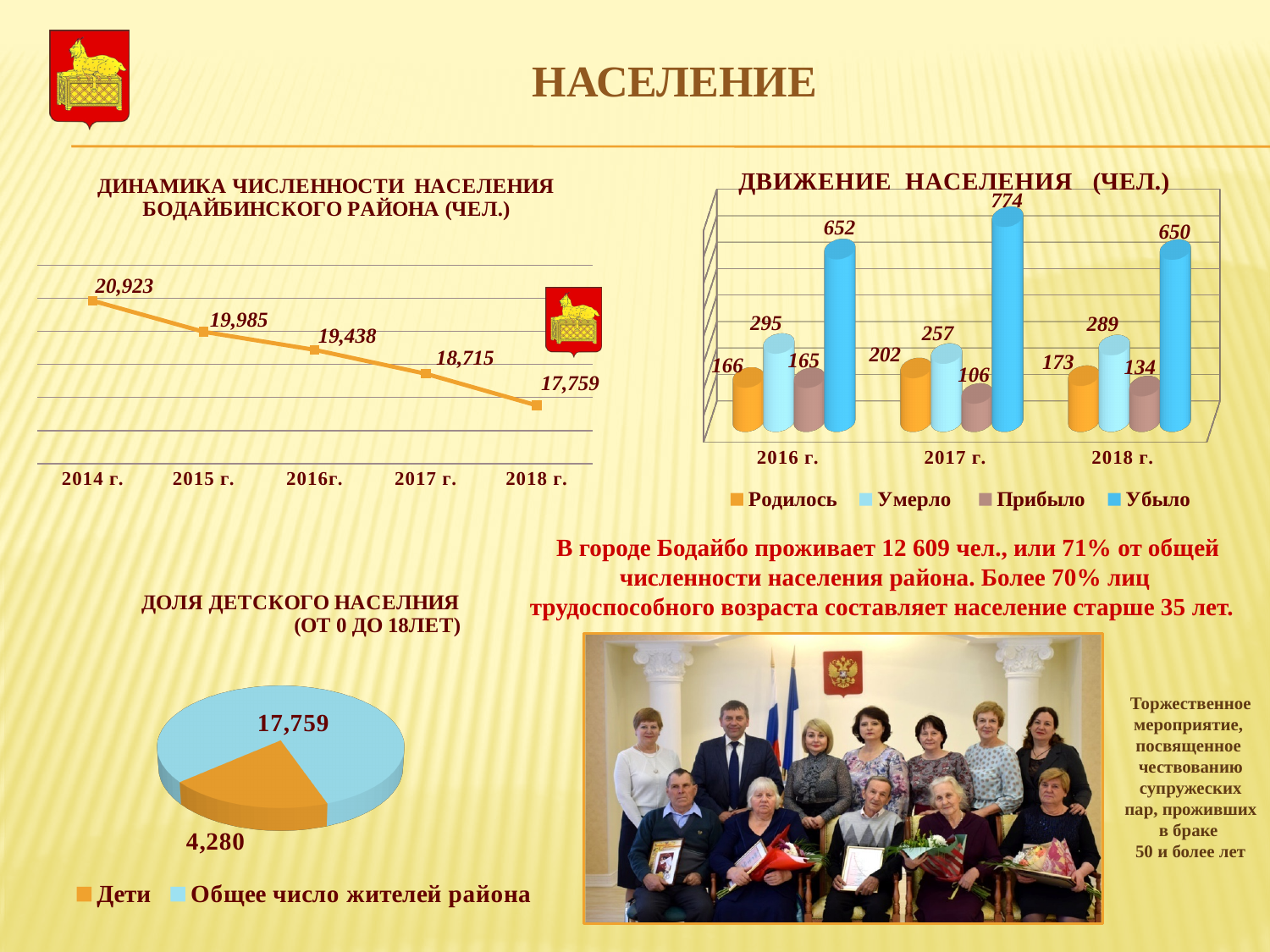
On the bar chart 'Движение населения (чел.)', what is the value for Прибыло in 2016 г.? 165 On the bar chart 'Движение населения (чел.)', what is the value for Убыло in 2017 г.? 774 On the bar chart 'Движение населения (чел.)', in which year is Родилось highest? 2017 г. On the line chart 'Динамика численности населения Бодайбинского района', what is the difference between the 2014 г. and 2018 г. values? 3,164 On the line chart 'Динамика численности населения Бодайбинского района', what is the value for 2014 г.? 20,923 On the bar chart 'Движение населения (чел.)', what is the difference between Умерло and Родилось in 2018 г.? 116 On the line chart 'Динамика численности населения Бодайбинского района', how many years are plotted? 5 On the pie chart 'Доля детского населения (от 0 до 18 лет)', what is the value for Дети? 4,280 On the line chart 'Динамика численности населения Бодайбинского района', do the values rise or fall from 2014 г. to 2018 г.? fall On the bar chart 'Движение населения (чел.)', how many series does the legend list? 4 What kind of chart is 'Движение населения (чел.)'? bar chart On the line chart 'Динамика численности населения Бодайбинского района', what is the value for 2018 г.? 17,759